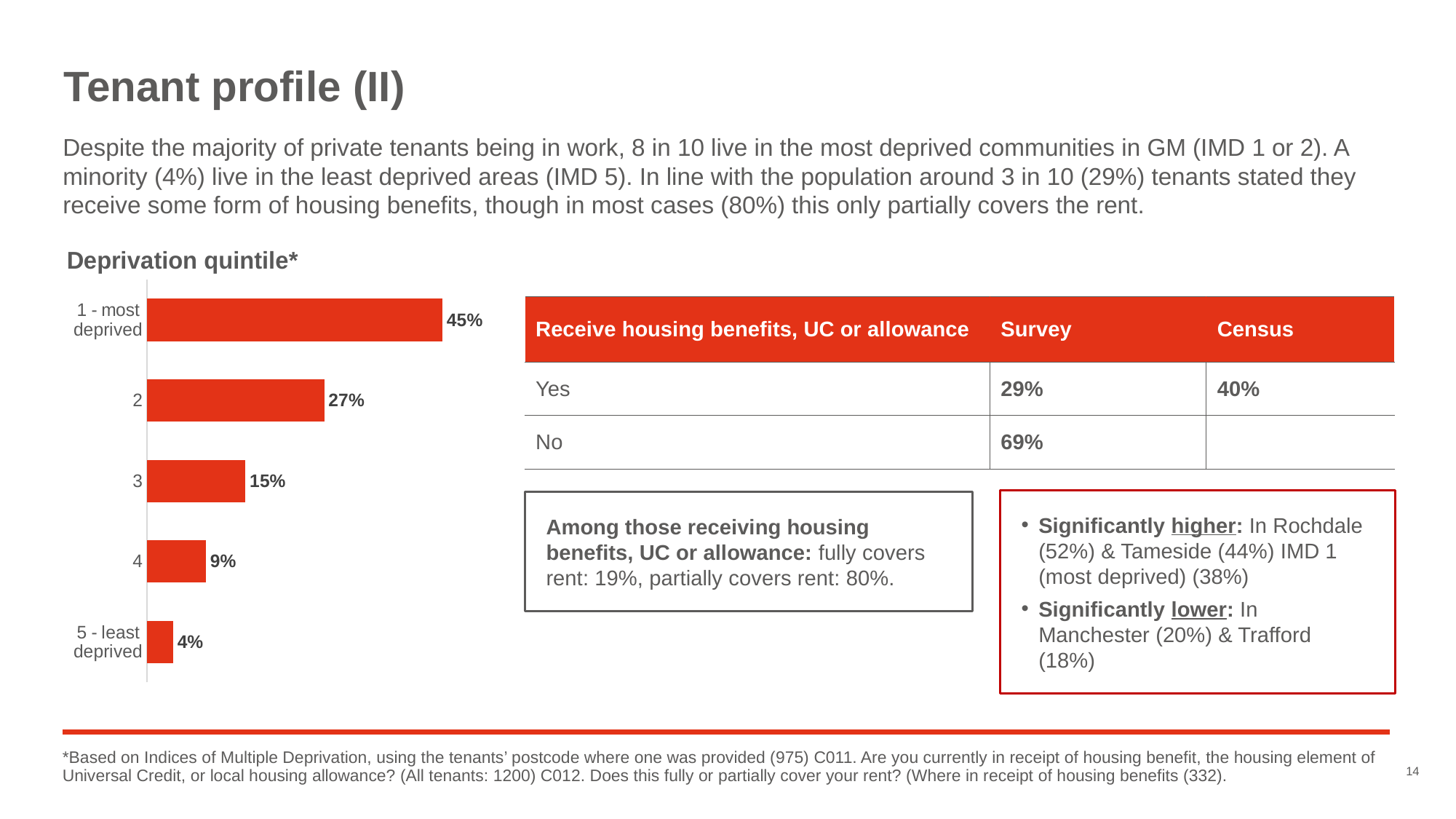
What is the value for quintile 2 in the Deprivation quintile chart? 27% What is the difference between the values for quintile 3 and quintile 4 in the Deprivation quintile chart? 6% Do the values in the Deprivation quintile chart rise or fall from quintile 1 to quintile 5? Fall How many categories are shown in the Deprivation quintile chart? 5 What is the difference between the values for quintile 1 - most deprived and quintile 2 in the Deprivation quintile chart? 18% Which quintile has the highest value in the Deprivation quintile chart? 1 - most deprived What is the value for quintile 5 - least deprived in the Deprivation quintile chart? 4% In the Deprivation quintile chart, which is larger: the value for quintile 2 or quintile 3? 2 What is the value for quintile 1 - most deprived in the Deprivation quintile chart? 45% Which quintile has the lowest value in the Deprivation quintile chart? 5 - least deprived What kind of chart is the Deprivation quintile chart? Bar chart What is the value for quintile 3 in the Deprivation quintile chart? 15%